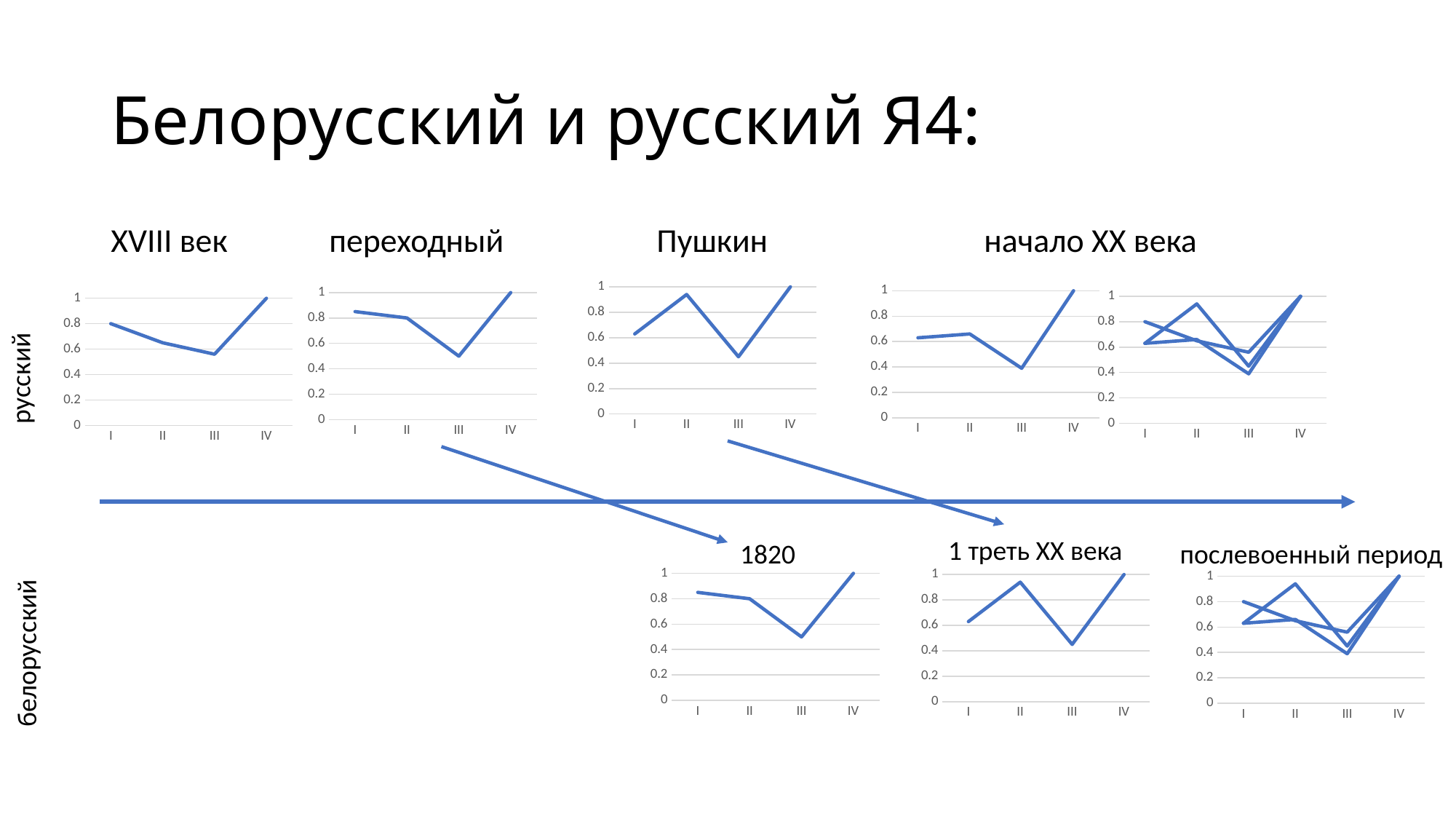
In the 'Пушкин' chart, which category has the lowest value? III In the 'XVIII век' chart, is the value for II greater or less than 0.8? less In the 'XVIII век' chart, which category has the lowest value? III In the '1 треть XX века' chart, is the value for I greater or less than 0.8? less How many categories are on the x axis of the 'XVIII век' chart? 4 In the 'XVIII век' chart, what is the value at category IV? 1 In the 'Пушкин' chart, which is larger, the value for II or the value for III? II In the 'переходный' chart, is the value for III greater or less than 0.6? less In the '1820' chart, do the values rise or fall from II to III? fall How many lines are plotted in the 'послевоенный период' chart? 3 What kind of chart is the 'XVIII век' chart? line chart